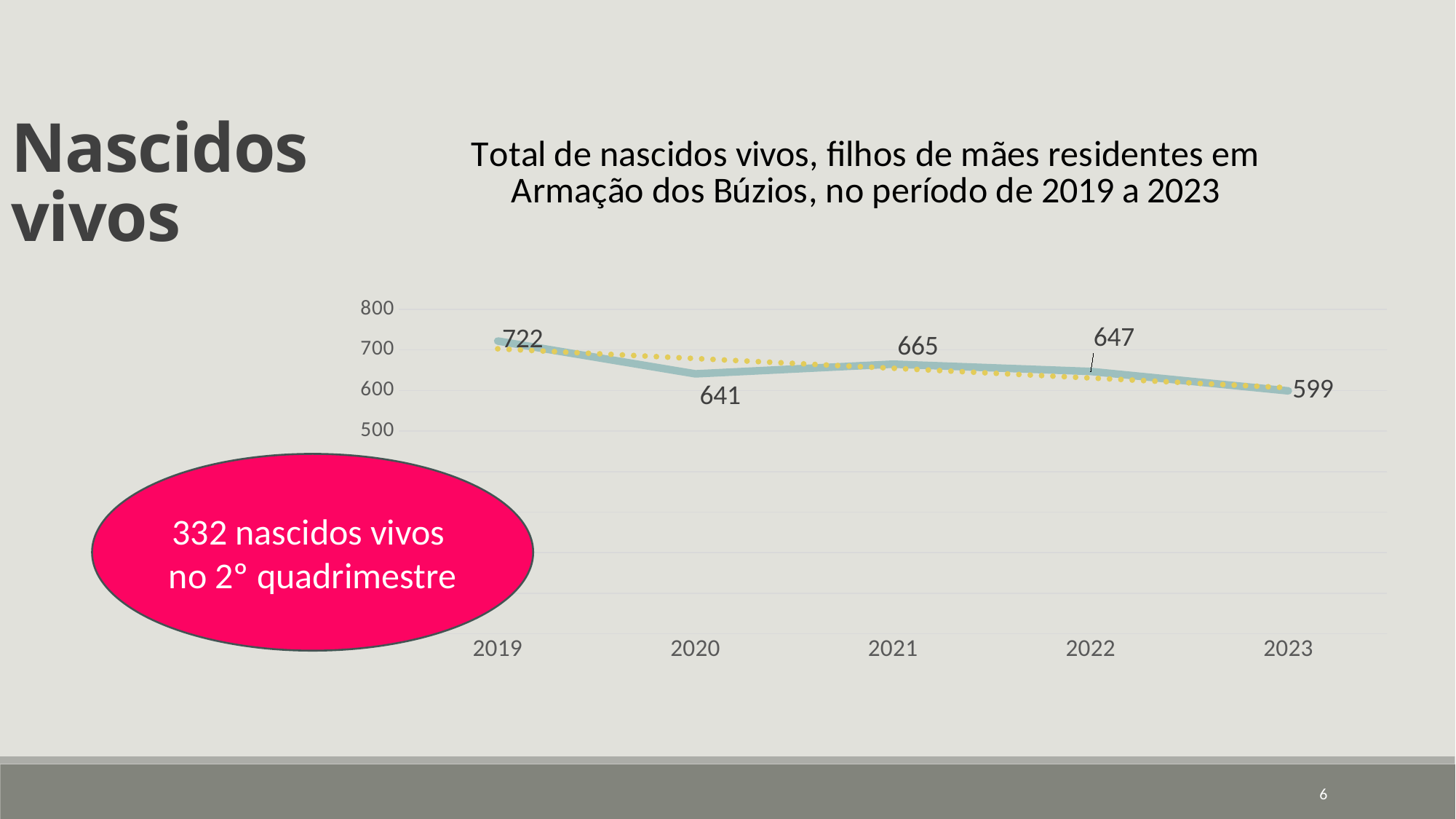
How many years are plotted on the chart? 5 What is the value for 2023? 599 Which is larger, the value for 2020 or the value for 2021? 2021 What is the value for 2022? 647 What is the difference between the values for 2019 and 2023? 123 Overall, do the values rise or fall from 2019 to 2023? fall What is the value for 2021? 665 What is the value for 2019? 722 What kind of chart is shown on the slide? line chart What is the value for 2020? 641 Which year has the lowest value? 2023 Which year has the highest value? 2019